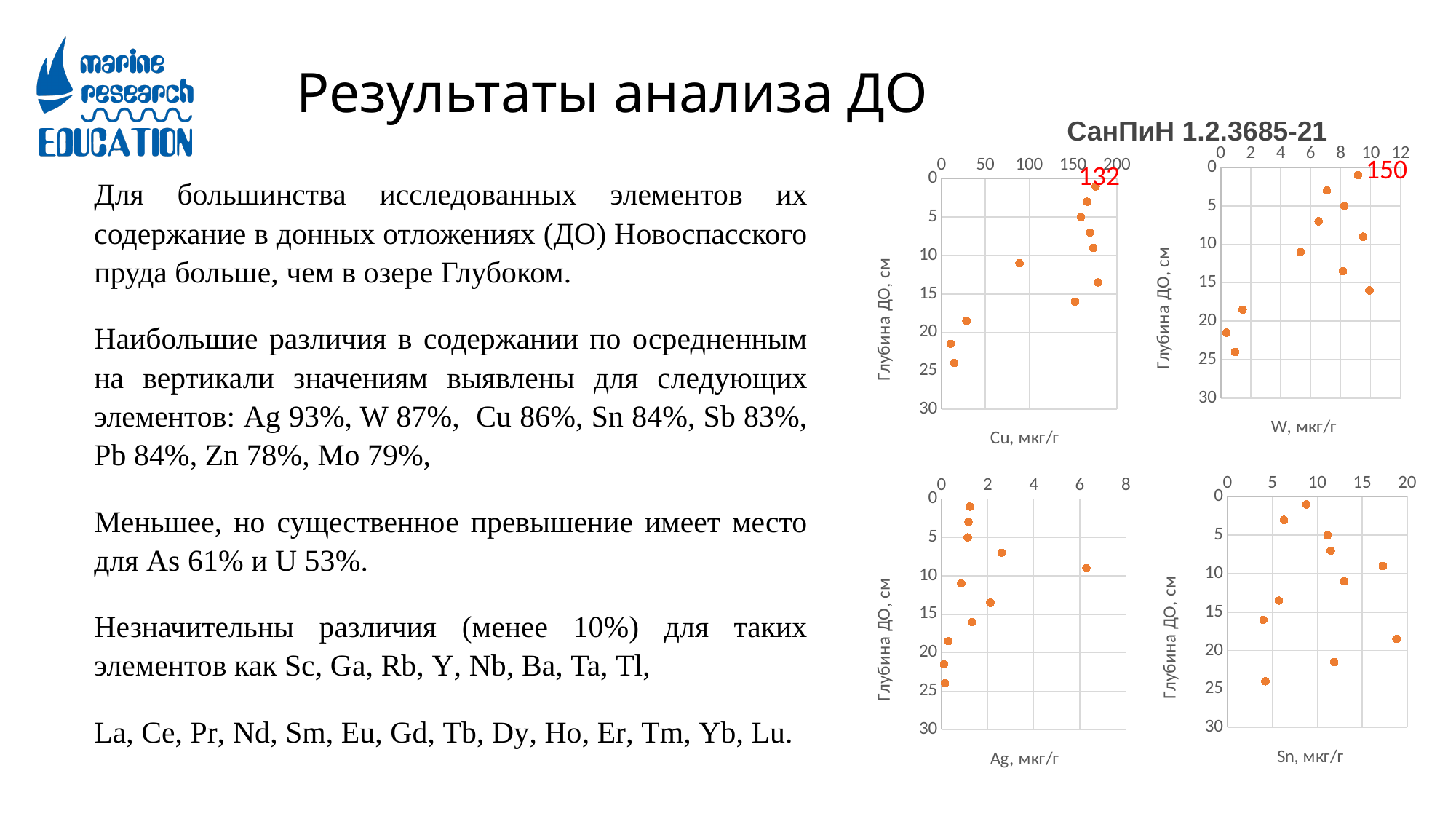
What is the y-axis label of the top-left chart (Cu, мкг/г)? Глубина ДО, см In the top-left chart (Cu, мкг/г), is the value at a depth of 24 cm greater or less than 50? less In the top-left chart (Cu, мкг/г), is the value at a depth of 11 cm greater or less than 100? less In the bottom-right chart (Sn, мкг/г), which is larger: the value at a depth of 18.5 cm or at a depth of 24 cm? 18.5 cm In the top-left chart (Cu, мкг/г), how many data points are plotted? 11 In the bottom-right chart (Sn, мкг/г), is the value at a depth of 24 cm greater or less than 10? less In the top-left chart (Cu, мкг/г), which is larger: the value at a depth of 11 cm or at a depth of 24 cm? 11 cm What kind of chart is the top-left chart (Cu, мкг/г)? scatter chart In the bottom-left chart (Ag, мкг/г), at which depth is the Ag value highest? 9 cm